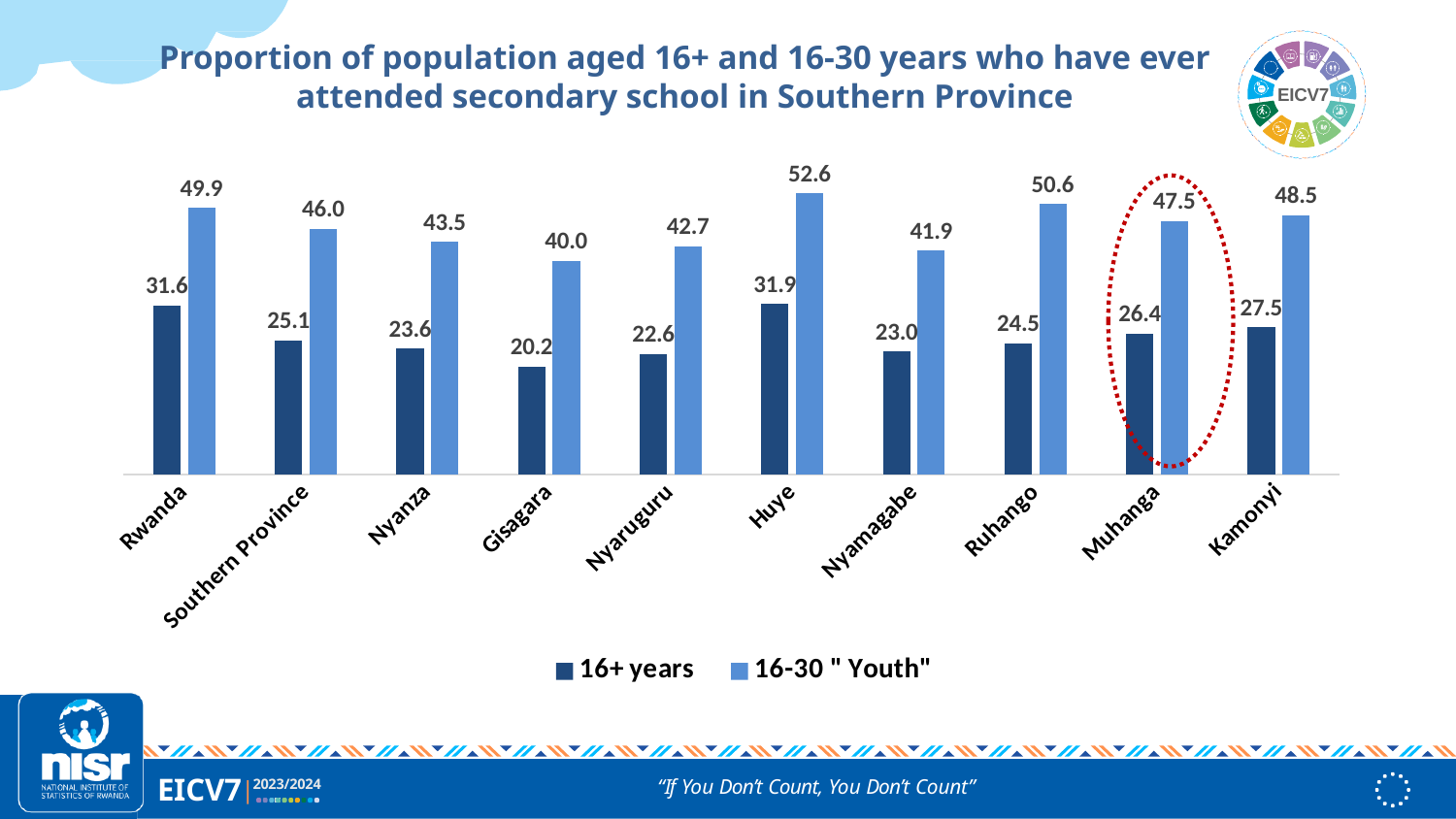
What kind of chart is shown on the slide? Bar chart What is the value for the 16-30 "Youth" series for Huye? 52.6 What is the value for the 16+ years series for Muhanga? 26.4 What is the value for the 16+ years series for Gisagara? 20.2 What is the difference between the 16-30 "Youth" value and the 16+ years value for Rwanda? 18.3 How many categories are shown on the x axis? 10 What is the difference between the 16-30 "Youth" value and the 16+ years value for Huye? 20.7 How many series does the legend list? 2 Which has the larger 16-30 "Youth" value, Ruhango or Kamonyi? Ruhango Which category has the lowest value for the 16+ years series? Gisagara What is the value for the 16-30 "Youth" series for Southern Province? 46.0 Which category has the highest value for the 16-30 "Youth" series? Huye